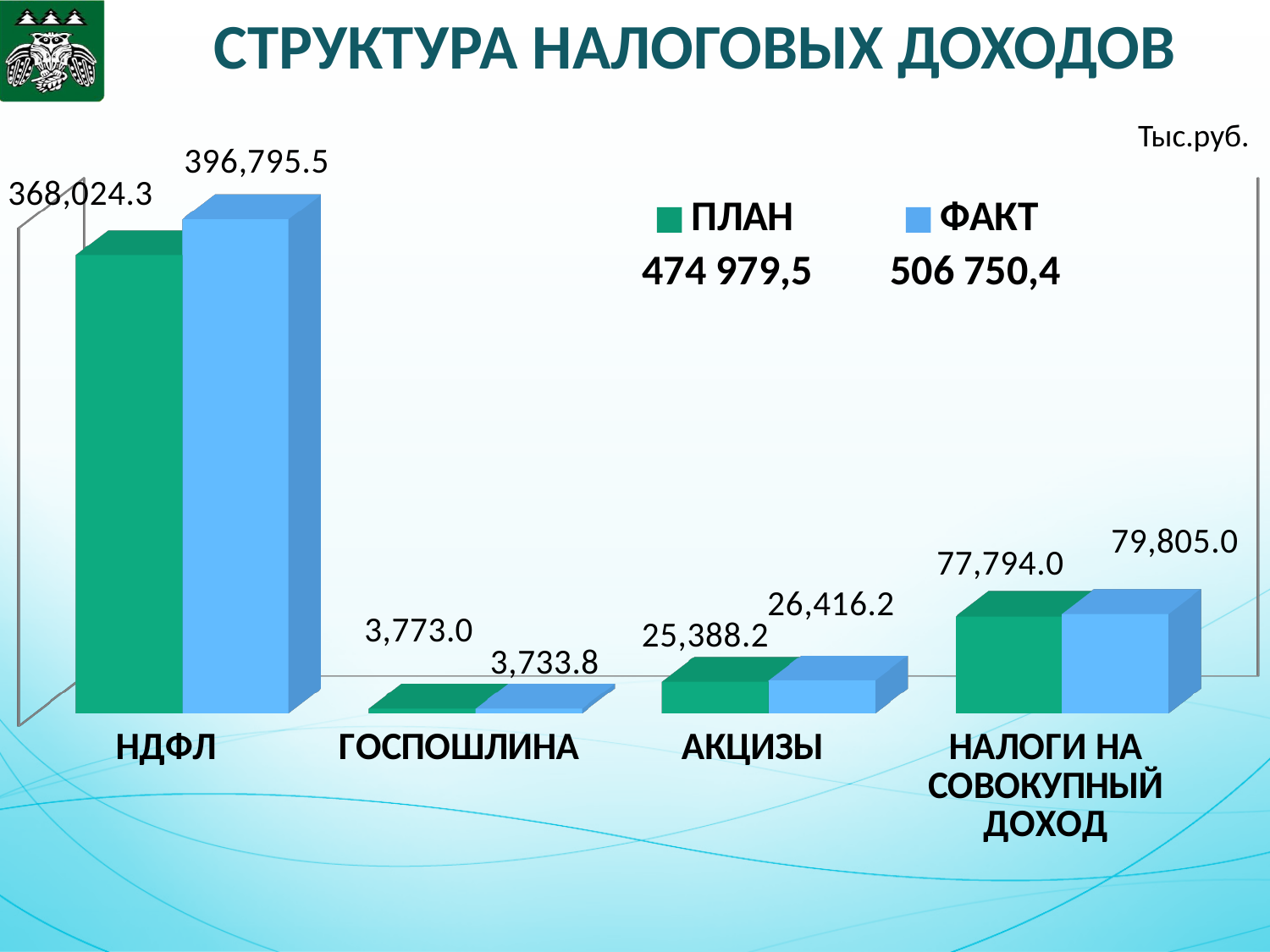
Which category has the lowest ПЛАН value? ГОСПОШЛИНА How many categories are shown on the x axis? 4 What is the difference between the ФАКТ and ПЛАН values for НДФЛ? 28,771.2 What is the difference between the ФАКТ and ПЛАН values for АКЦИЗЫ? 1,028.0 What kind of chart is shown on the slide? Bar chart How many series does the legend list? 2 What is the ПЛАН value for ГОСПОШЛИНА? 3,773.0 Which category has the highest ФАКТ value? НДФЛ What is the ФАКТ value for АКЦИЗЫ? 26,416.2 What is the ПЛАН value for НДФЛ? 368,024.3 What is the ФАКТ value for НАЛОГИ НА СОВОКУПНЫЙ ДОХОД? 79,805.0 For НДФЛ, which is larger: the ПЛАН value or the ФАКТ value? ФАКТ